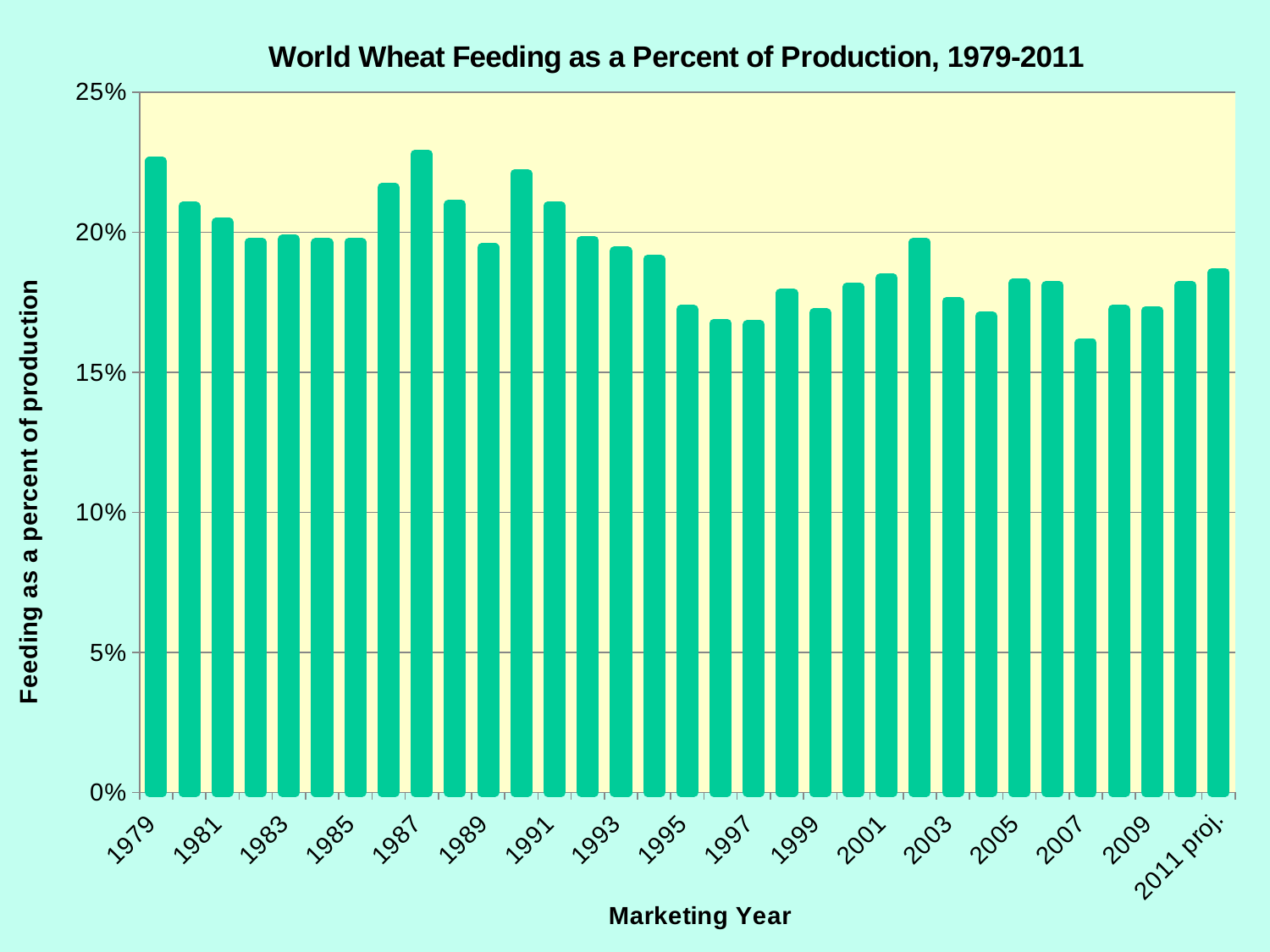
Is the value for 1991 greater or less than 20%? greater How many bars (marketing years) are plotted in the chart? 33 What kind of chart is shown on the slide? bar chart What is the title of the chart? World Wheat Feeding as a Percent of Production, 1979-2011 Is the value for 1997 greater or less than 15%? greater What is the label of the x axis? Marketing Year Is the value for 1979 greater or less than 20%? greater Which is larger, the value for 1987 or the value for 2007? 1987 Overall, do the values rise or fall from 1979 to 2011 proj.? fall Which marketing year has the lowest feeding as a percent of production? 2007 Which is larger, the value for 1979 or the value for 1995? 1979